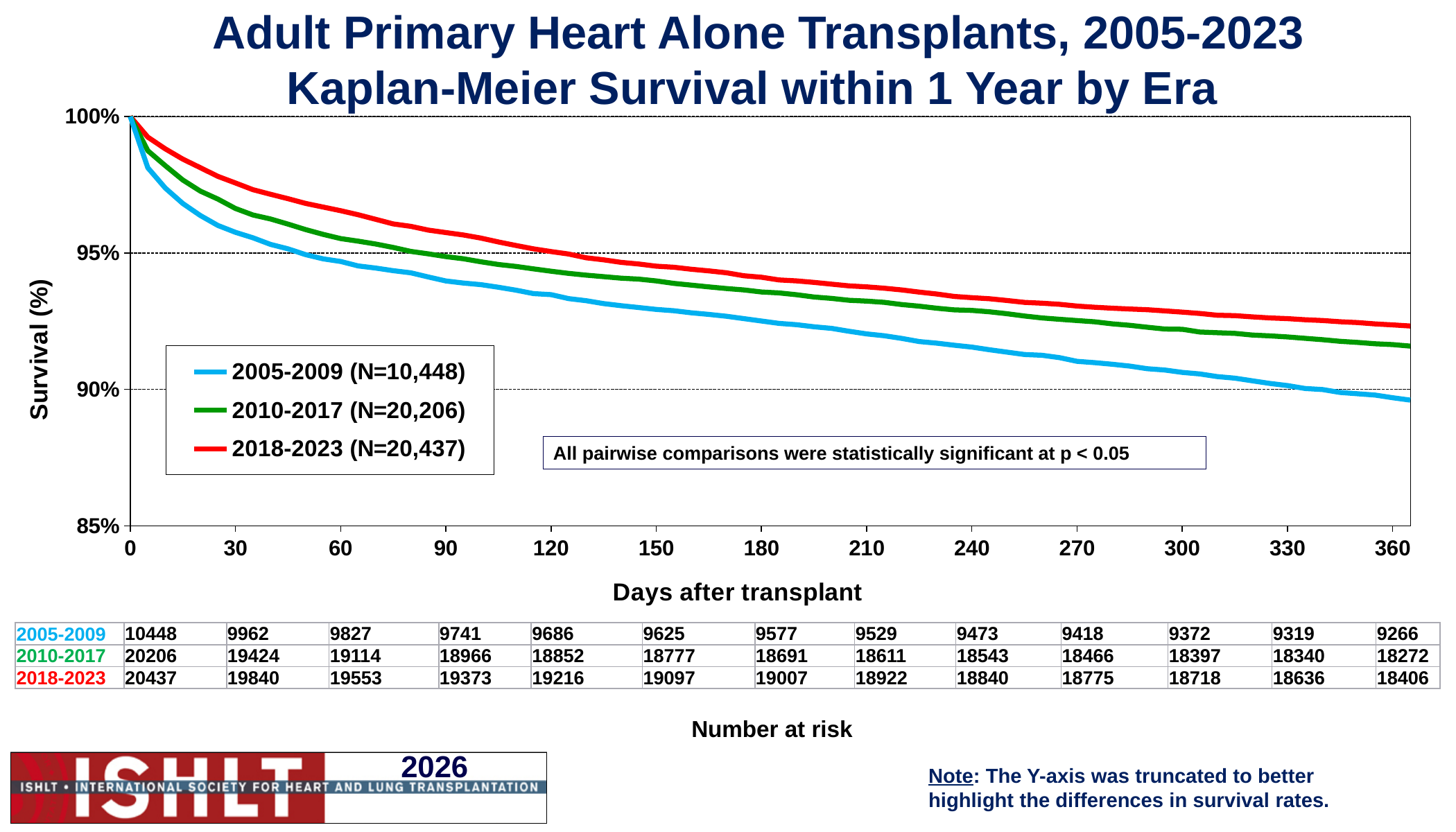
In the number at risk table, what is the number at risk for the 2018-2023 era at 360 days? 18406 What kind of chart is shown on the slide? line chart Is the survival for the 2018-2023 era at 60 days greater or less than 95%? greater In the number at risk table, what is the difference between the number at risk for the 2005-2009 era at day 0 and at day 360? 1182 Is the survival for the 2005-2009 era at 360 days greater or less than 90%? less In the number at risk table, what is the number at risk for the 2010-2017 era at 180 days? 18691 Which era has the highest survival at 360 days after transplant? 2018-2023 Is the survival for the 2010-2017 era at 180 days greater or less than 95%? less Which era has the lowest survival at 360 days after transplant? 2005-2009 What sample size (N) does the legend give for the 2005-2009 era? N=10,448 How many series does the legend list? 3 Do the survival curves rise or fall as days after transplant increase? fall